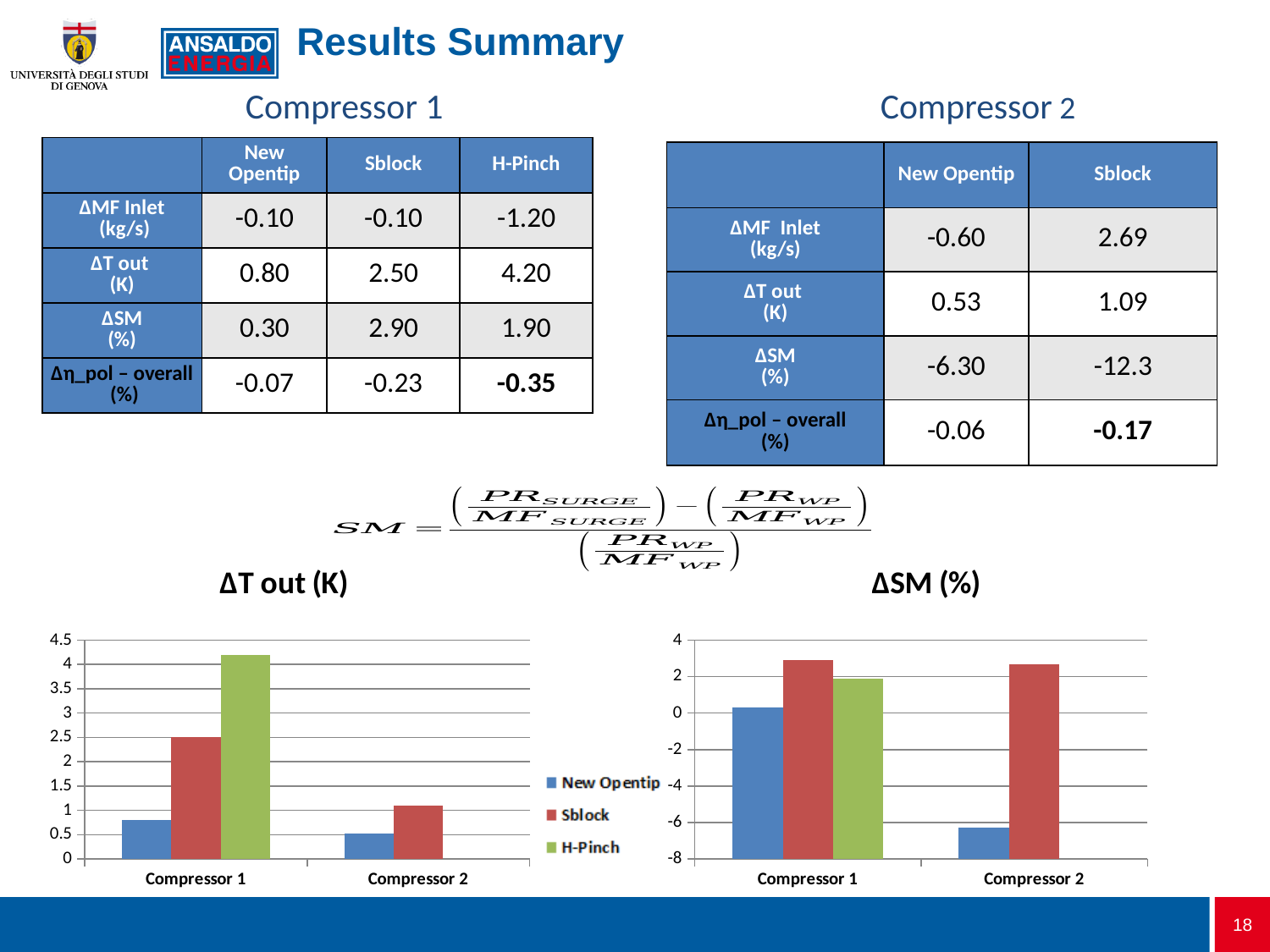
In the ΔT out (K) chart, is the H-Pinch value for Compressor 1 greater or less than 4? greater In the ΔT out (K) chart, is the New Opentip value for Compressor 2 greater or less than 1? less In the ΔSM (%) chart, is the Sblock value for Compressor 2 greater or less than 0? greater What colour represents the Sblock series in the charts? red In the ΔT out (K) chart, is the Sblock value larger for Compressor 1 or Compressor 2? Compressor 1 How many series does the legend of the ΔT out (K) chart list? 3 In the ΔT out (K) chart, which series has the highest bar for Compressor 1? H-Pinch In the ΔSM (%) chart, which bar is the lowest overall? New Opentip for Compressor 2 How many categories are shown on the x axis of the ΔSM (%) chart? 2 What kind of chart is the ΔT out (K) chart? bar chart In the ΔSM (%) chart, which series has the highest bar for Compressor 1? Sblock